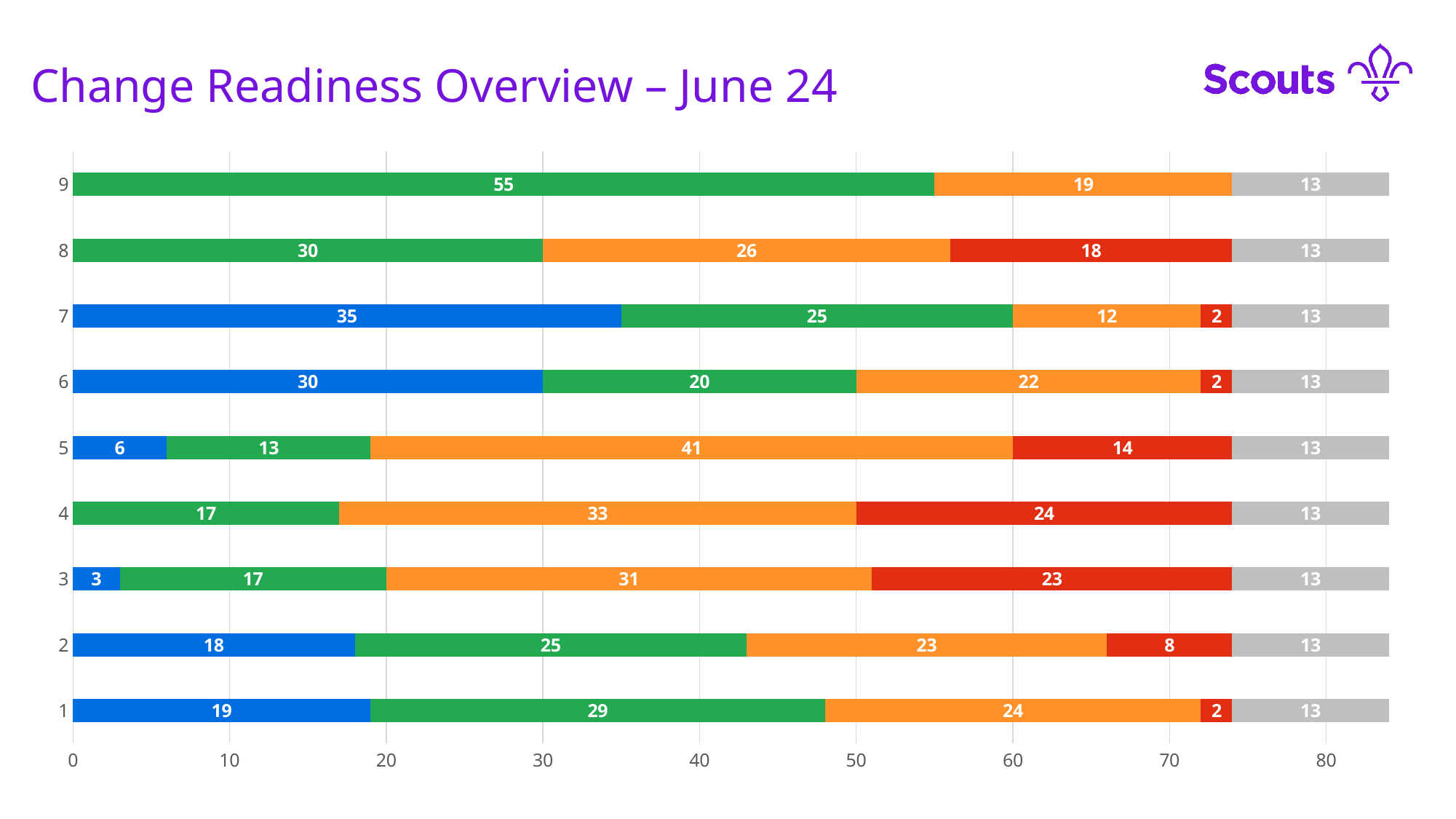
Which is larger: the red segment for category 3 or the red segment for category 8? Category 3 How many categories (rows) are plotted on the chart? 9 What is the value of the blue segment for category 7? 35 What is the difference between the orange segment for category 5 and the orange segment for category 7? 29 Which category has the smallest blue segment? 3 What is the total of the stacked bar for category 8? 87 What kind of chart is shown on the slide? Stacked bar chart What is the value of the orange segment for category 5? 41 What is the value of the red segment for category 4? 24 What is the title of the chart? Change Readiness Overview – June 24 Which category has the largest green segment? 9 What is the value of the green segment for category 9? 55